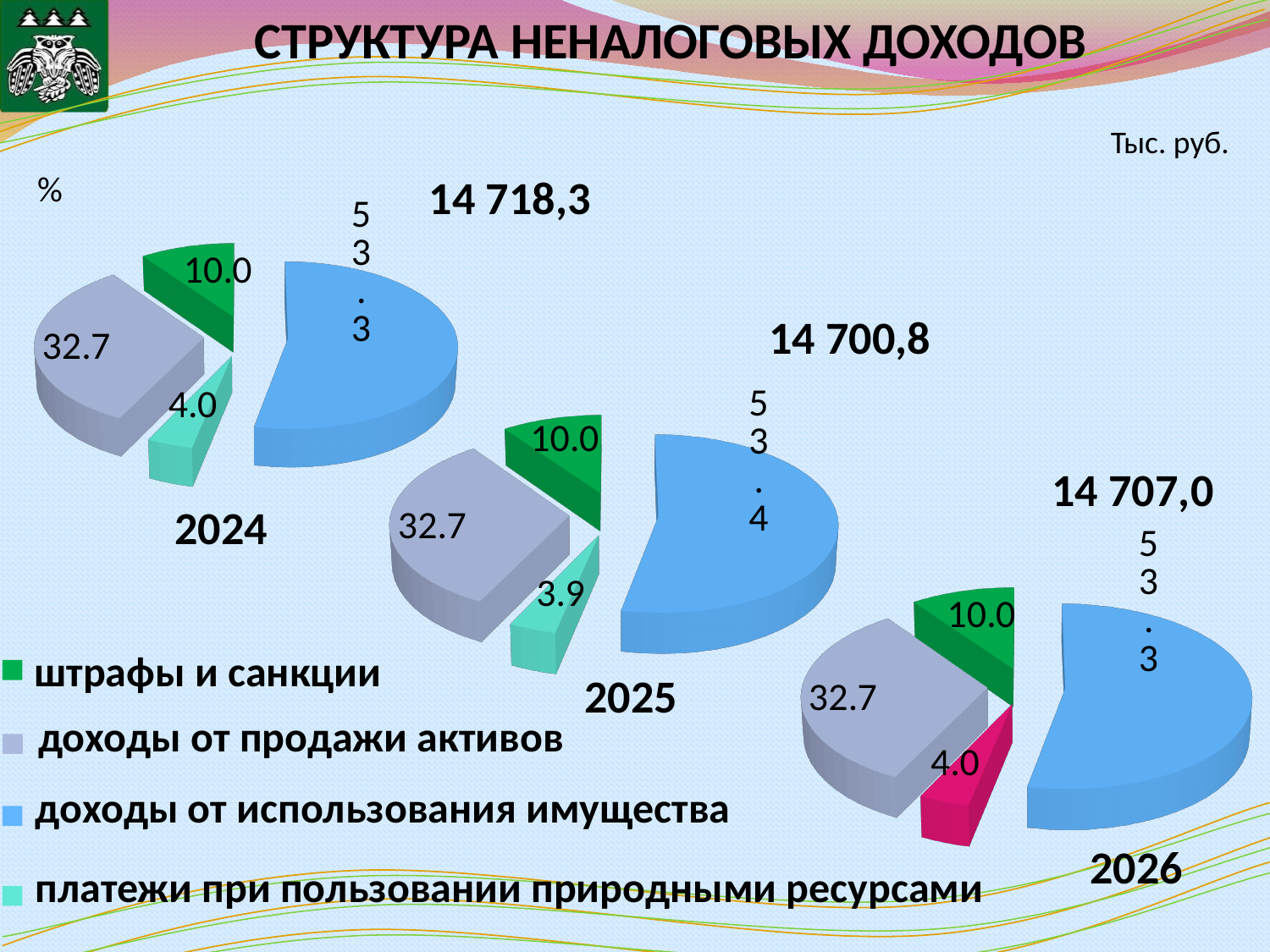
In the 2024 pie chart, what is the share for доходы от использования имущества? 53.3 In the 2025 pie chart, what is the share for платежи при пользовании природными ресурсами? 3.9 In the 2026 pie chart, what is the share for доходы от продажи активов? 32.7 How many pie charts are shown on the slide? 3 In the 2025 pie chart, which category has the largest share? доходы от использования имущества In the 2026 pie chart, what is the difference between the shares for доходы от продажи активов and штрафы и санкции? 22.7 In the 2024 pie chart, which is larger: the share for доходы от продажи активов or the share for штрафы и санкции? доходы от продажи активов How many categories does the legend list for the pie charts? 4 In the 2025 pie chart, what is the share for штрафы и санкции? 10.0 What kind of chart is used to show the structure of non-tax revenues for each year on this slide? pie chart What total value (тыс. руб.) is shown above the 2025 pie chart? 14 700,8 In the 2024 pie chart, which category has the smallest share? платежи при пользовании природными ресурсами